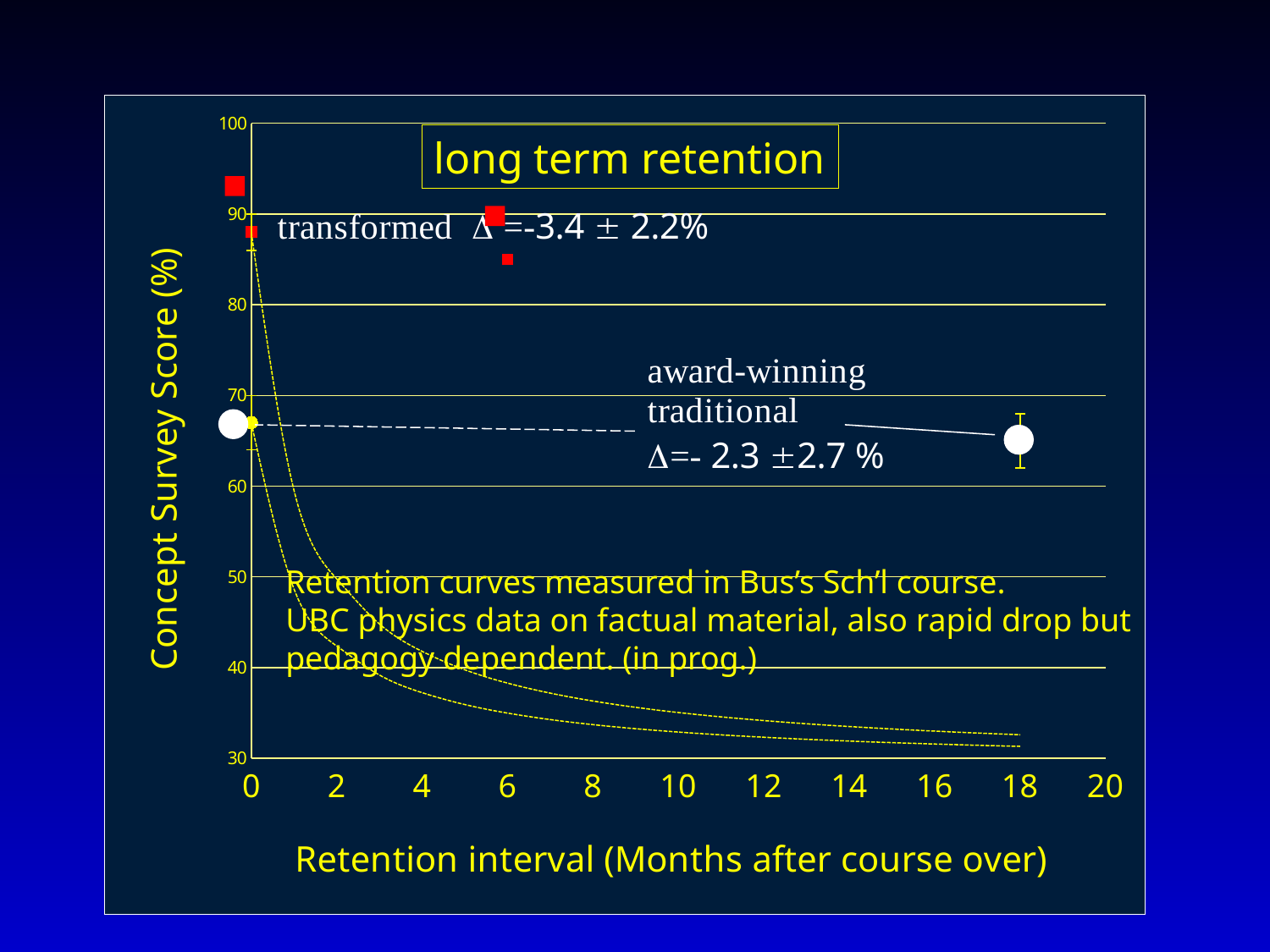
What change (Δ) is printed for the award-winning traditional course? -2.3 ± 2.7 % At what retention interval is the second traditional-course data point plotted? 18 What is the title of the chart? long term retention What change (Δ) is printed for the transformed course? -3.4 ± 2.2% Is the traditional course's score at 0 months greater or less than 60? greater What is the label of the y axis? Concept Survey Score (%) Which course has the higher concept survey score at 0 months, transformed or traditional? transformed Are the dashed retention curves at 18 months greater or less than 40? less Do the dashed retention curves rise or fall as the retention interval increases? fall Is the transformed course's score at 0 months greater or less than 80? greater What is the highest value shown on the y axis? 100